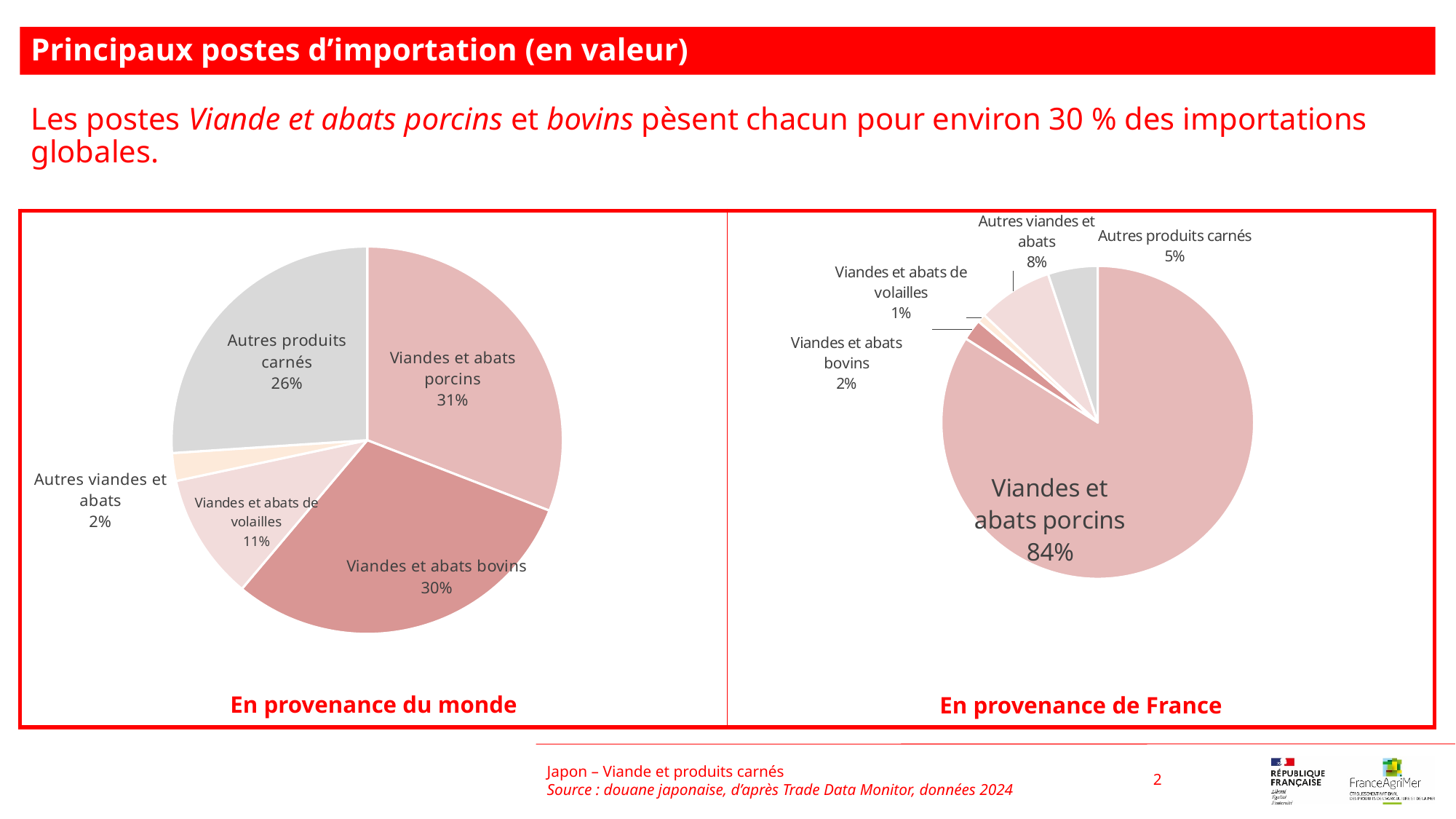
In the 'En provenance de France' pie chart, what share do Autres viandes et abats represent? 8% What is the title of the slide? Principaux postes d’importation (en valeur) In the 'En provenance du monde' pie chart, what share do Viandes et abats de volailles represent? 11% In the 'En provenance du monde' pie chart, which category has the largest share? Viandes et abats porcins In the 'En provenance de France' pie chart, what share do Viandes et abats porcins represent? 84% In the 'En provenance de France' pie chart, which is larger: Autres produits carnés or Viandes et abats bovins? Autres produits carnés In the 'En provenance de France' pie chart, which category has the smallest share? Viandes et abats de volailles What type of chart is used for 'En provenance de France'? Pie chart In the 'En provenance du monde' pie chart, how many categories are shown? 5 In the 'En provenance du monde' pie chart, which category has the smallest share? Autres viandes et abats In the 'En provenance du monde' pie chart, what is the difference between the shares of Viandes et abats bovins and Autres produits carnés? 4% In the 'En provenance du monde' pie chart, what share do Viandes et abats porcins represent? 31%